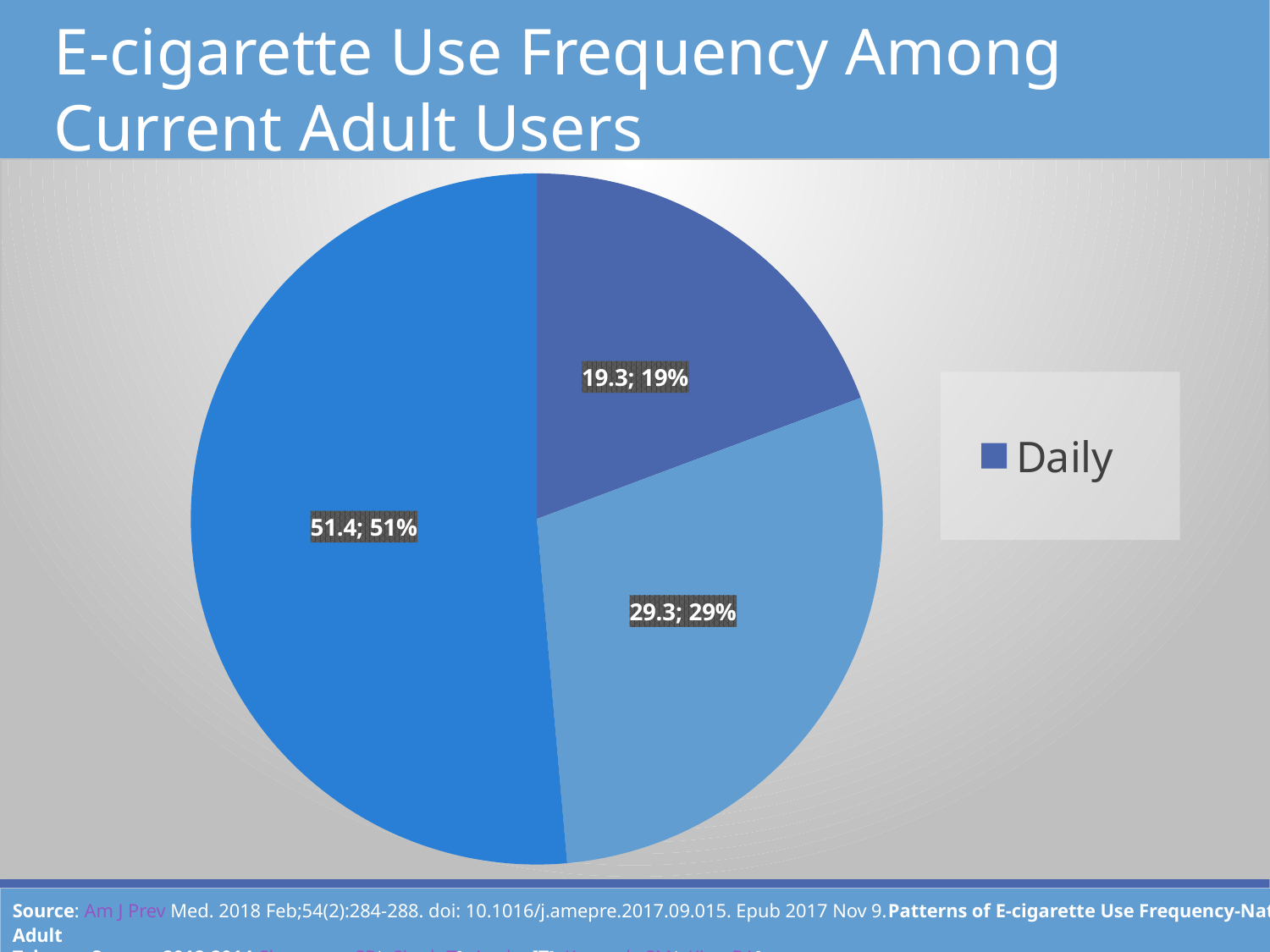
Which legend entry is visible next to the pie chart? Daily What percentage of the pie does the Daily slice represent? 19% Is the largest slice of the pie greater or less than 50% of the whole? greater What is the difference between the largest slice value (51.4) and the Daily slice value (19.3)? 32.1 What is the difference between the slice labeled 29.3 and the Daily slice labeled 19.3? 10 What percentage is shown on the smallest slice of the pie chart? 19% Which is larger: the Daily slice or the slice labeled 29.3; 29%? the slice labeled 29.3; 29% What is the value printed on the largest slice of the pie chart? 51.4 What kind of chart is shown on the slide? pie chart What is the title of the chart on the slide? E-cigarette Use Frequency Among Current Adult Users How many slices does the pie chart have? 3 What value is printed on the Daily slice of the pie chart? 19.3